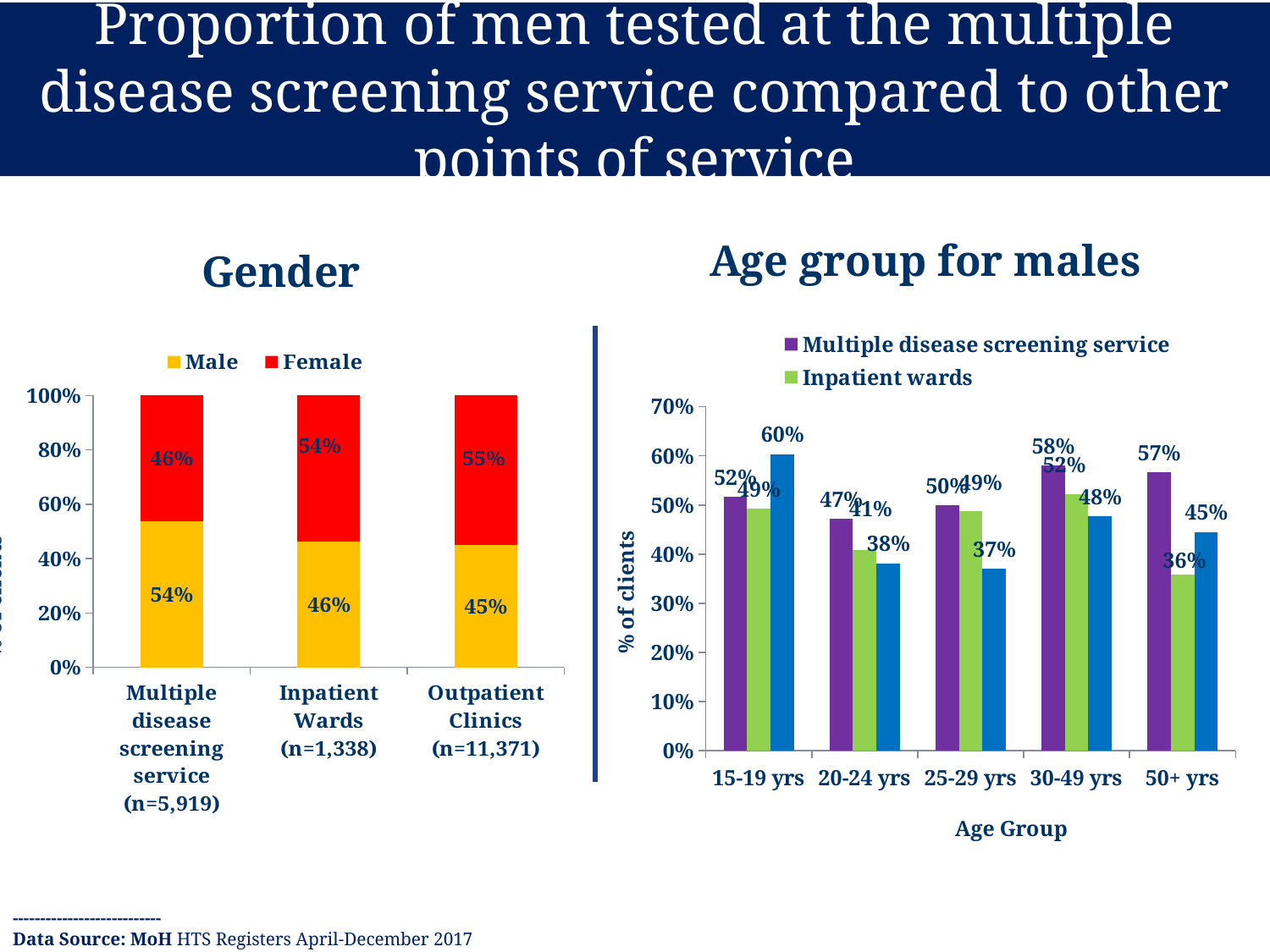
In the Age group for males chart, what is the value for Inpatient wards in the 50+ yrs age group? 36% How many series does the legend of the Gender chart list? 2 In the Age group for males chart, what is the value for the Multiple disease screening service in the 30-49 yrs age group? 58% In the Gender chart, which point of service has the highest proportion of male clients? Multiple disease screening service In the Age group for males chart, what is the difference between the Multiple disease screening service and Inpatient wards values for the 50+ yrs age group? 21 percentage points In the Age group for males chart, which age group has the lowest Inpatient wards value? 50+ yrs What kind of chart is the Gender chart? Stacked bar chart In the Gender chart, what percentage of clients at Outpatient Clinics were female? 55% How many age groups are shown on the x axis of the Age group for males chart? 5 How many points of service are shown on the x axis of the Gender chart? 3 In the Gender chart, what percentage of clients at the Multiple disease screening service were male? 54% In the Age group for males chart, for the 20-24 yrs age group, which is larger: the Multiple disease screening service value or the Inpatient wards value? Multiple disease screening service